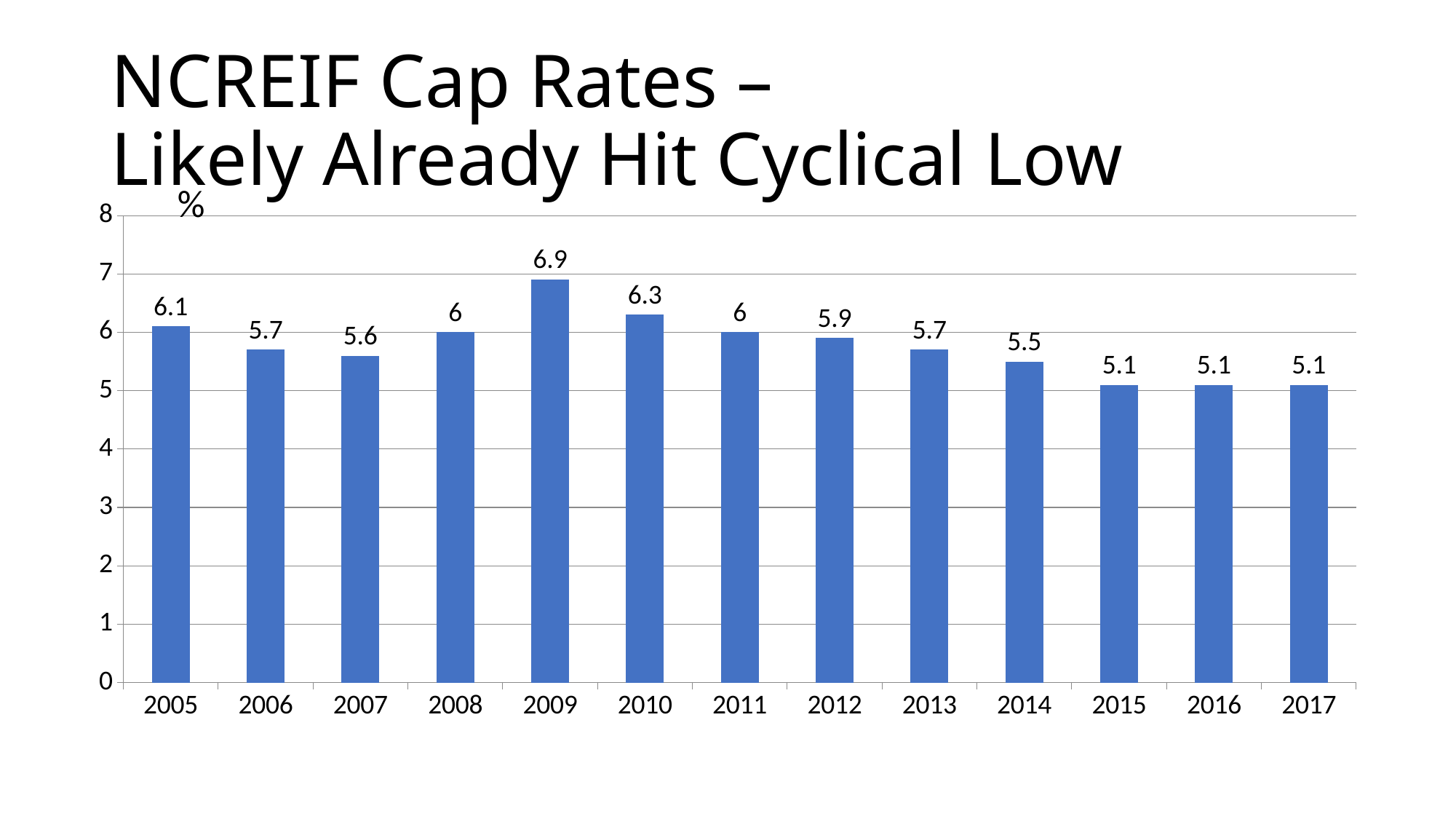
What kind of chart is shown on the slide? Bar chart What is the cap rate value shown for 2014? 5.5 Which is larger, the value for 2008 or the value for 2013? 2008 Do the values generally rise or fall from 2009 to 2017? Fall Is the value for 2009 greater or less than 6? greater Which year has the highest cap rate? 2009 What is the difference between the 2010 value and the 2012 value? 0.4 What is the title of the slide? NCREIF Cap Rates – Likely Already Hit Cyclical Low What is the cap rate value shown for 2005? 6.1 What is the cap rate value shown for 2009? 6.9 How many years are shown on the x axis? 13 What is the difference between the 2009 value and the 2017 value? 1.8